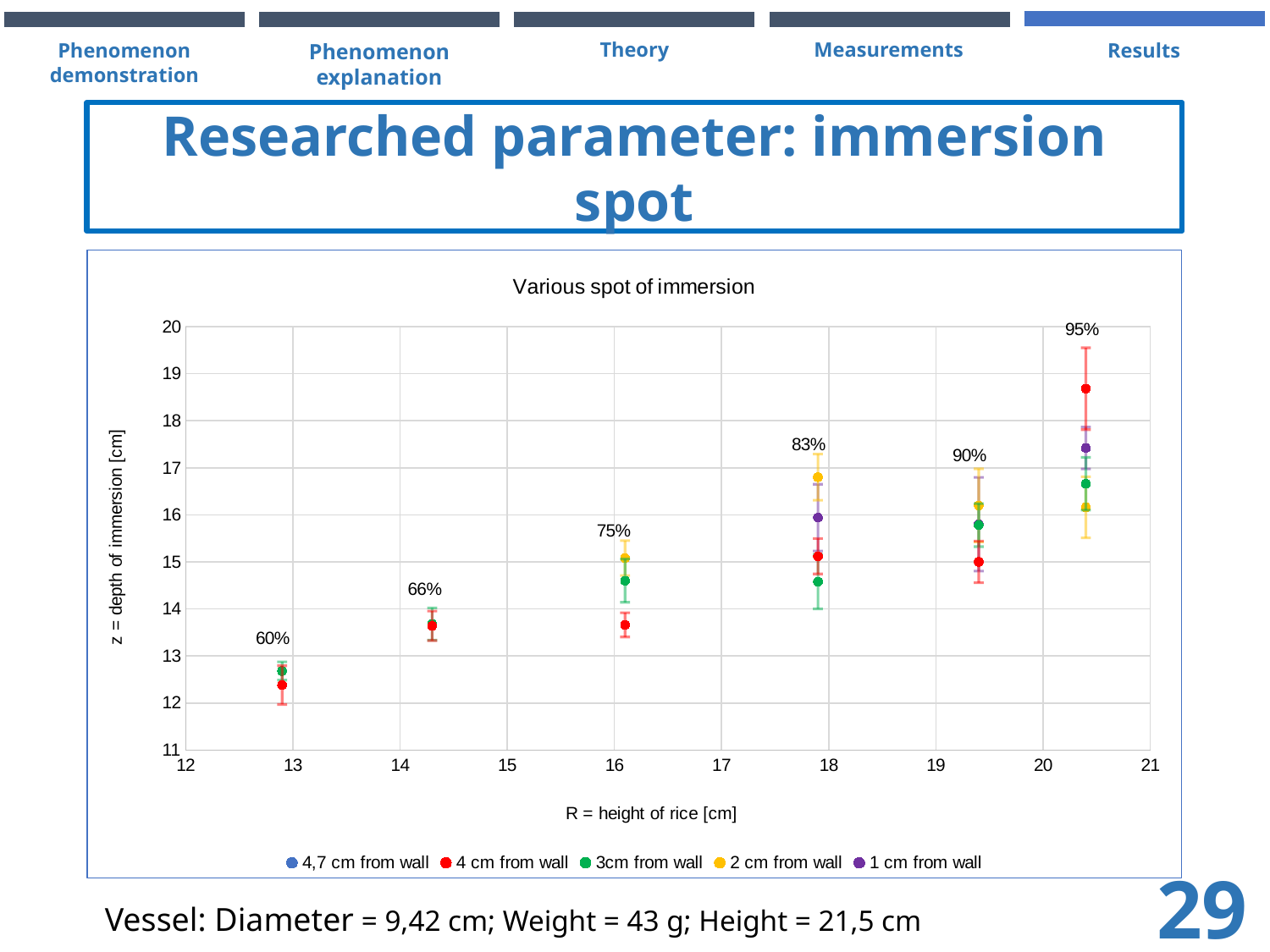
Which series has the highest point in the 95% group? 4 cm from wall Is the value for the '3cm from wall' series at the 83% group greater or less than 15? less In the 83% group, which is larger: the value for '2 cm from wall' or the value for '4 cm from wall'? 2 cm from wall Is the value for the '4 cm from wall' series at the 95% group greater or less than 18? greater What kind of chart is shown on the slide? scatter chart Is the value for the '4 cm from wall' series at the 60% group greater or less than 13? less Do the depths of immersion generally rise or fall as the height of rice increases? rise What is the label of the x axis? R = height of rice [cm] What is the title of the chart? Various spot of immersion How many series does the legend of the chart list? 5 How many percentage labels (groups of points) are plotted along the x axis? 6